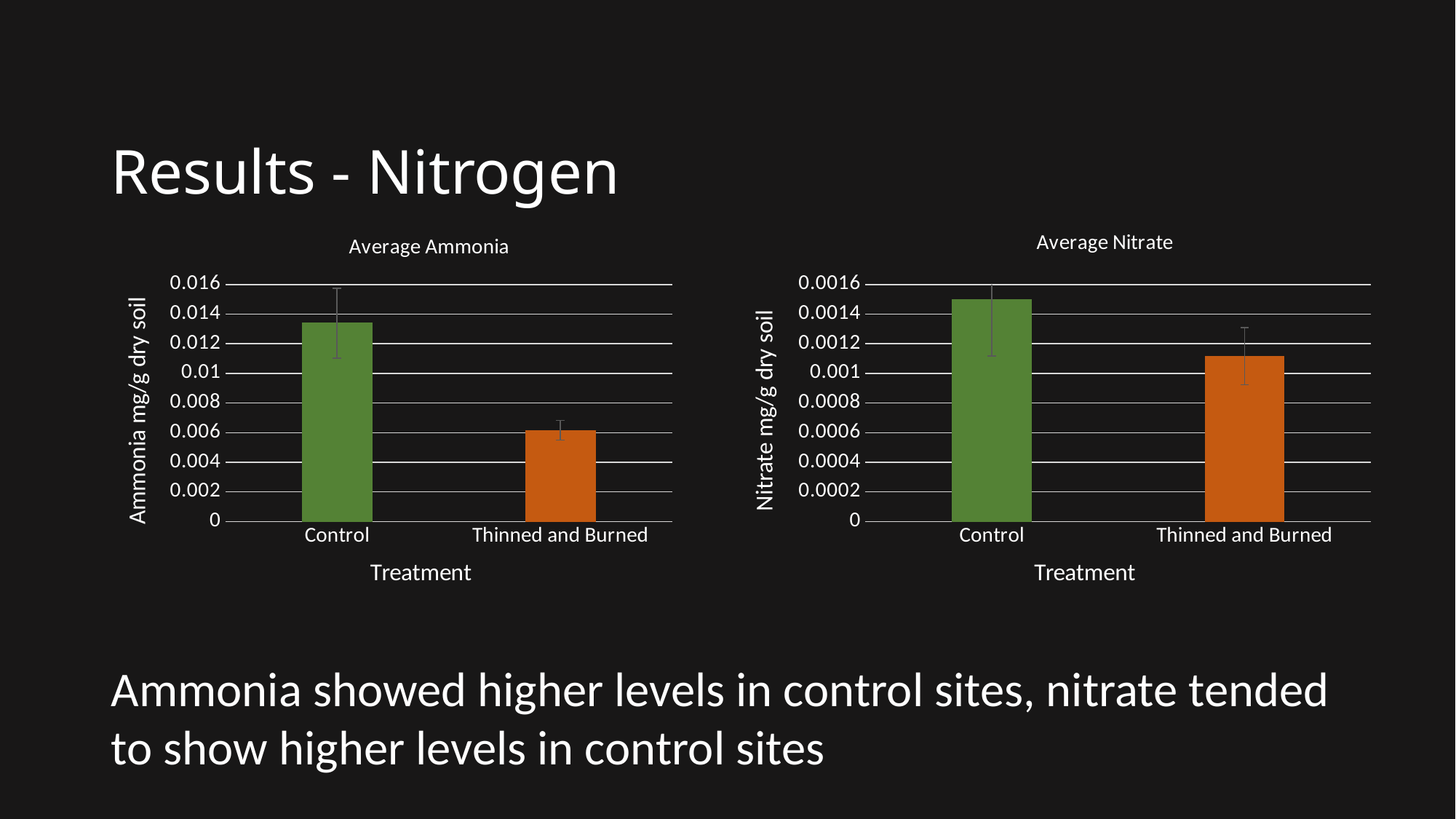
In the Average Ammonia chart, is the value for Control greater or less than 0.012? greater In the Average Ammonia chart, is the value for Thinned and Burned greater or less than 0.008? less In the Average Nitrate chart, which is larger, the value for Control or the value for Thinned and Burned? Control In the Average Nitrate chart, is the value for Thinned and Burned greater or less than 0.0012? less What kind of chart is the Average Nitrate chart? bar chart How many treatment categories are shown in the Average Ammonia chart? 2 In the Average Ammonia chart, which treatment has the highest ammonia level? Control In the Average Ammonia chart, which treatment has the lowest ammonia level? Thinned and Burned What is the y-axis label of the Average Ammonia chart? Ammonia mg/g dry soil In the Average Nitrate chart, which treatment has the highest nitrate level? Control What is the x-axis label of the Average Nitrate chart? Treatment